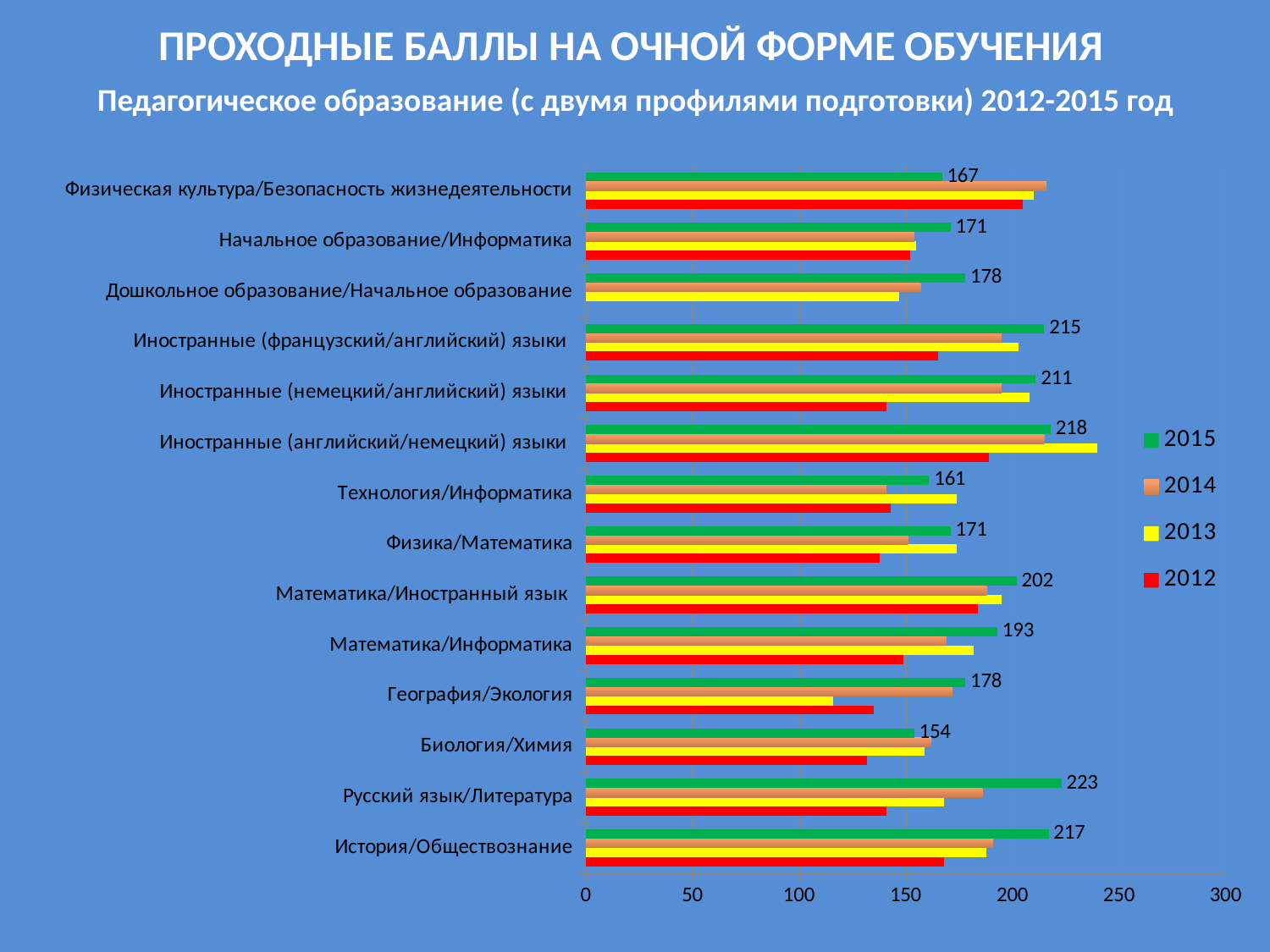
Which has the larger 2015 value: Иностранные (французский/английский) языки or Технология/Информатика? Иностранные (французский/английский) языки How many categories (programme profiles) are shown on the chart? 14 What is the 2015 value for Математика/Информатика? 193 What is the difference between the 2015 values for Русский язык/Литература and Биология/Химия? 69 Which category has the lowest 2015 value? Биология/Химия Is the 2012 value for Иностранные (немецкий/английский) языки greater or less than 150? less What is the 2015 value for Биология/Химия? 154 How many series does the legend list? 4 Is the 2013 value for Иностранные (английский/немецкий) языки greater or less than 200? greater What type of chart is shown on the slide? bar chart Which category has the highest 2015 value? Русский язык/Литература What is the 2015 value for Русский язык/Литература? 223